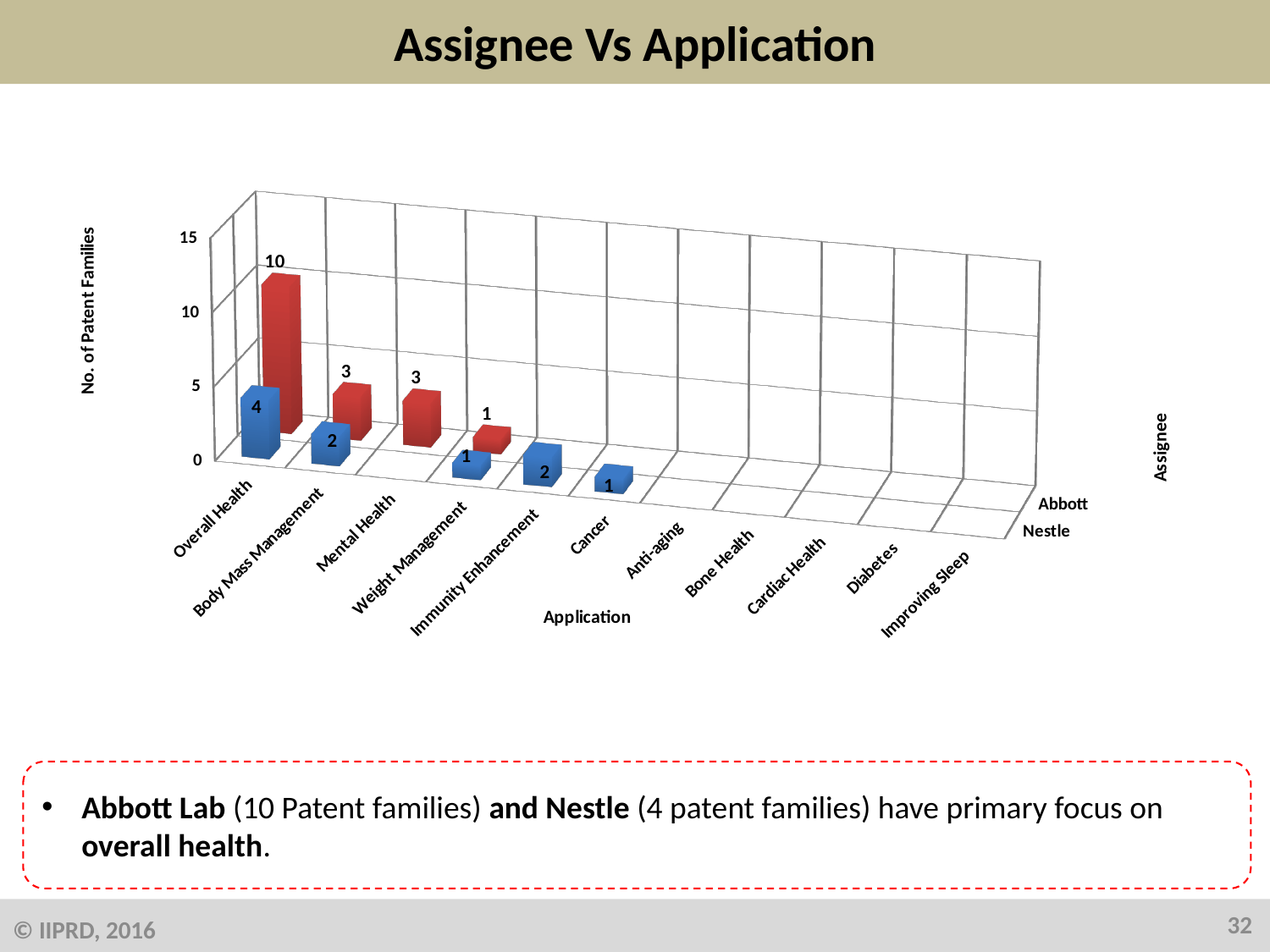
What is the number of patent families for Abbott in Overall Health? 10 Which is larger in Body Mass Management, Abbott's value or Nestle's value? Abbott What kind of chart is shown on the slide? Bar chart How many application categories are shown on the x axis? 11 What is the difference between Abbott's and Nestle's patent families in Overall Health? 6 How many assignees (series) does the chart show? 2 What is the number of patent families for Abbott in Mental Health? 3 What is the label of the vertical axis? No. of Patent Families What is the number of patent families for Nestle in Cancer? 1 What is the number of patent families for Nestle in Immunity Enhancement? 2 What is the number of patent families for Nestle in Overall Health? 4 Which application has the highest number of patent families for Abbott? Overall Health